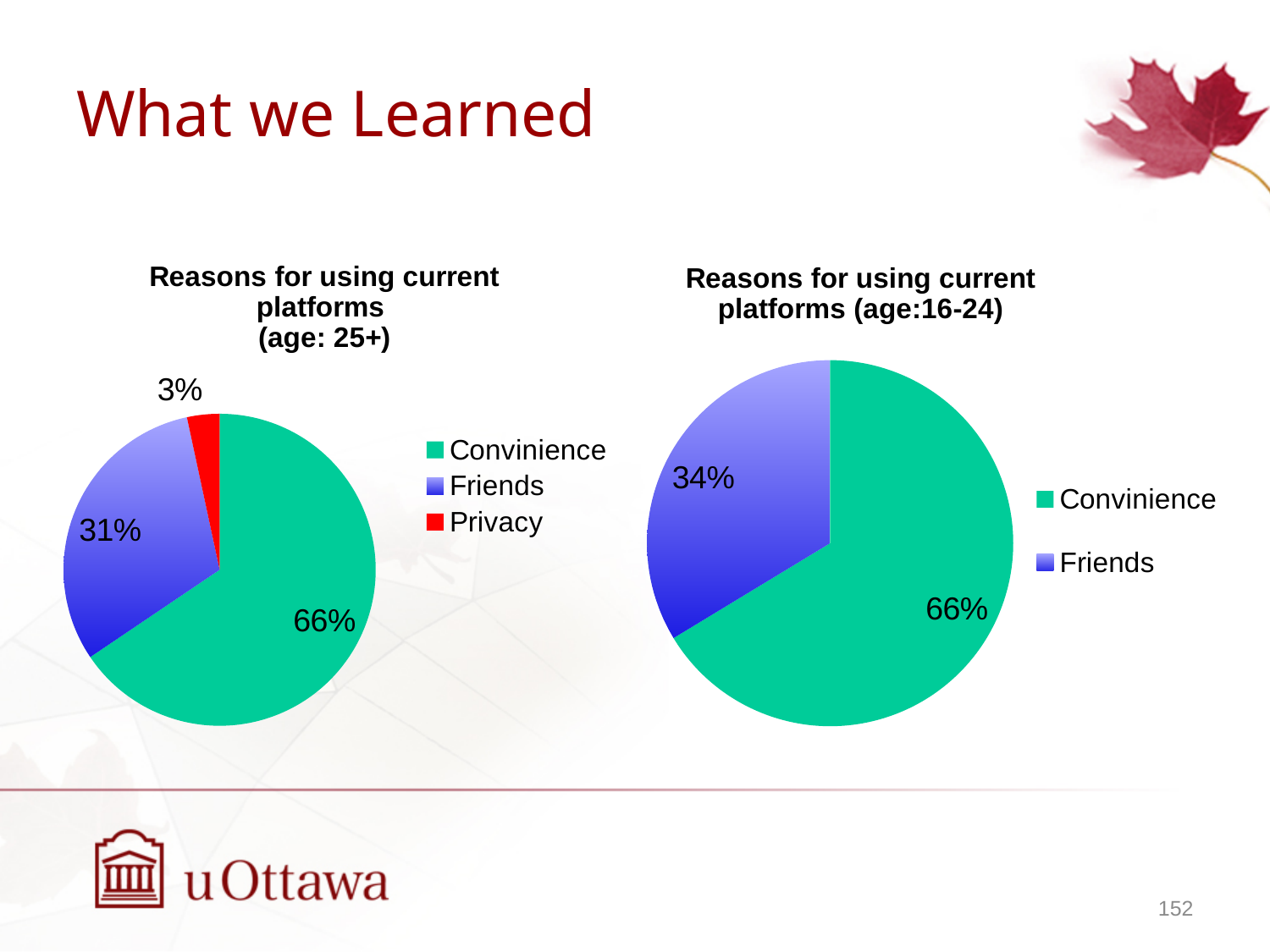
In the 'Reasons for using current platforms (age: 25+)' chart, what is the difference between the Convinience and Friends shares? 35% What type of chart is the 'Reasons for using current platforms (age:16-24)' chart? Pie chart In the 'Reasons for using current platforms (age:16-24)' chart, what share does Friends have? 34% In the 'Reasons for using current platforms (age:16-24)' chart, what share does Convinience have? 66% In the 'Reasons for using current platforms (age: 25+)' chart, what share does Privacy have? 3% In the 'Reasons for using current platforms (age: 25+)' chart, what share does Convinience have? 66% In the 'Reasons for using current platforms (age: 25+)' chart, which category has the smallest slice? Privacy In the 'Reasons for using current platforms (age: 25+)' chart, what share does Friends have? 31% How many slices does the 'Reasons for using current platforms (age: 25+)' pie chart have? 3 In the 'Reasons for using current platforms (age: 25+)' chart, which category has the largest slice? Convinience How many slices does the 'Reasons for using current platforms (age:16-24)' pie chart have? 2 In the 'Reasons for using current platforms (age:16-24)' chart, which category has the larger slice? Convinience